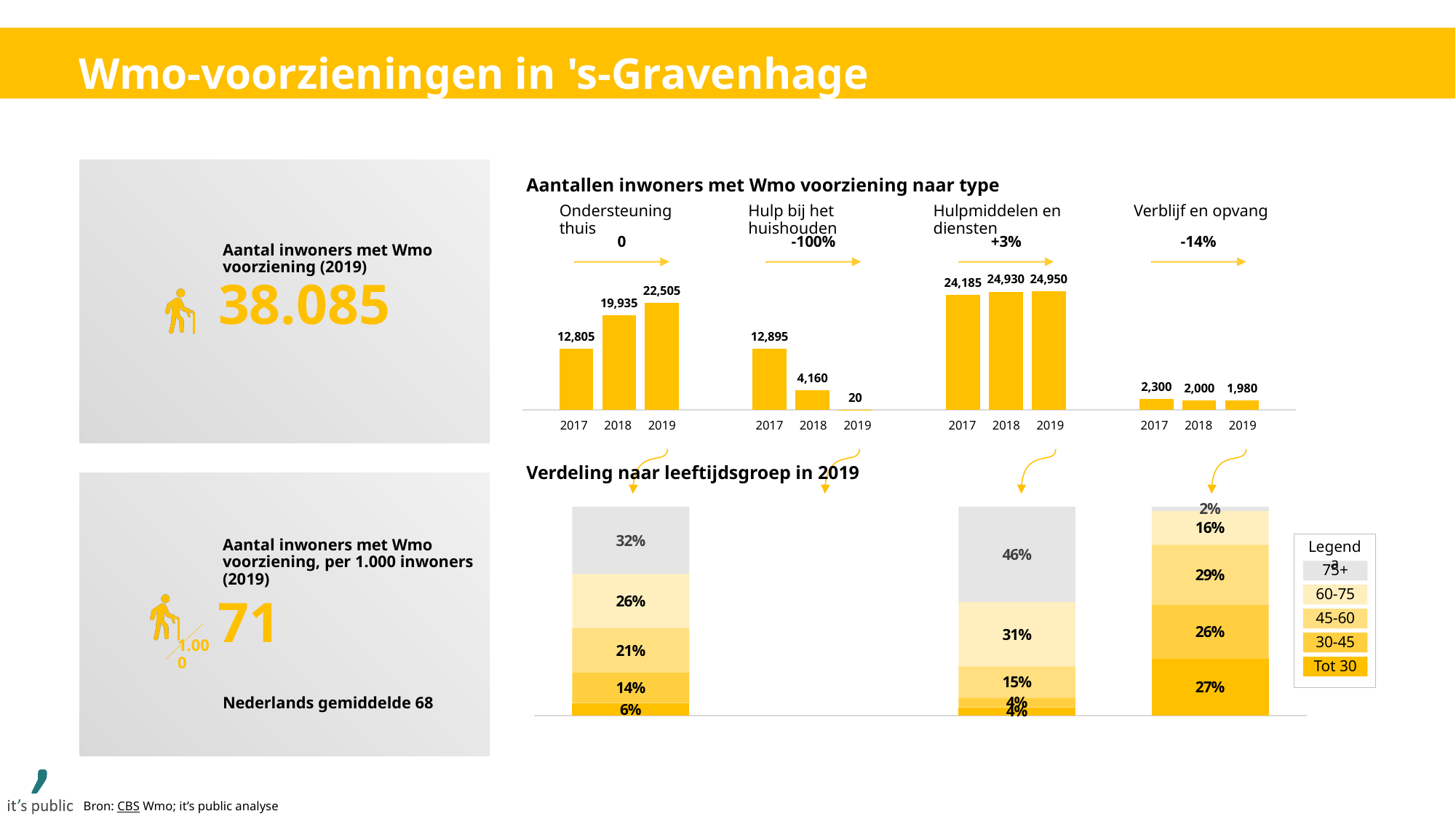
In the 'Hulp bij het huishouden' bar chart, what is the value for 2018? 4,160 What kind of chart is used for 'Verdeling naar leeftijdsgroep in 2019'? stacked bar chart How many years are shown on the x axis of the 'Verblijf en opvang' bar chart? 3 In the 'Ondersteuning thuis' bar chart, do the values rise or fall from 2017 to 2019? rise In the 'Verdeling naar leeftijdsgroep in 2019' chart, what share of the 'Verblijf en opvang' bar is the 'Tot 30' age group? 27% In the 'Ondersteuning thuis' bar chart, what is the value for 2019? 22,505 In the 'Hulpmiddelen en diensten' bar chart, is the value for 2017 larger or smaller than the value for 2019? smaller In the 'Verdeling naar leeftijdsgroep in 2019' chart, what share of the 'Hulpmiddelen en diensten' bar is the 75+ age group? 46% In the 'Verblijf en opvang' bar chart, which year has the highest value? 2017 In the 'Ondersteuning thuis' bar chart, what is the difference between the 2019 and 2017 values? 9,700 In the 'Hulp bij het huishouden' bar chart, which year has the lowest value? 2019 How many age groups does the legend of the 'Verdeling naar leeftijdsgroep in 2019' chart list? 5